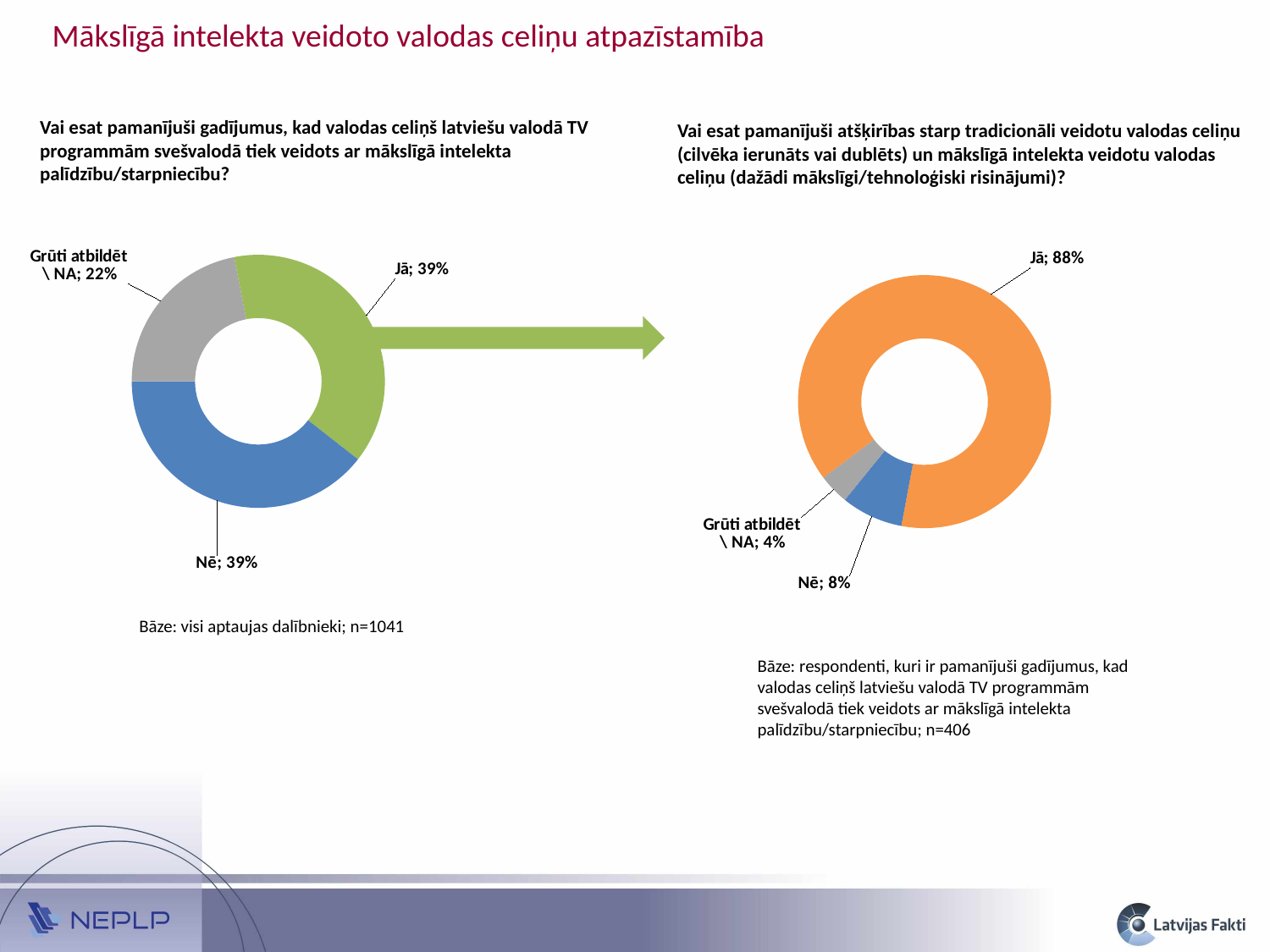
In the right chart, which category has the smallest share? Grūti atbildēt \ NA In the right chart, what is the difference in percentage points between "Jā" and "Nē"? 80 In the left chart, which category has the smallest share? Grūti atbildēt \ NA What type of chart is used on the right side of the slide? Donut (pie) chart In the right chart, what percentage of respondents answered "Nē"? 8% In the left chart, what percentage is shown for "Grūti atbildēt \ NA"? 22% In the right chart, which category has the largest share? Jā In the right chart, which is larger: the share for "Nē" or the share for "Grūti atbildēt \ NA"? Nē How many categories does the left chart show? 3 In the right chart, what percentage of respondents answered "Jā"? 88% In the left chart, what percentage of respondents answered "Jā"? 39% In the left chart, what is the difference in percentage points between "Jā" and "Grūti atbildēt \ NA"? 17